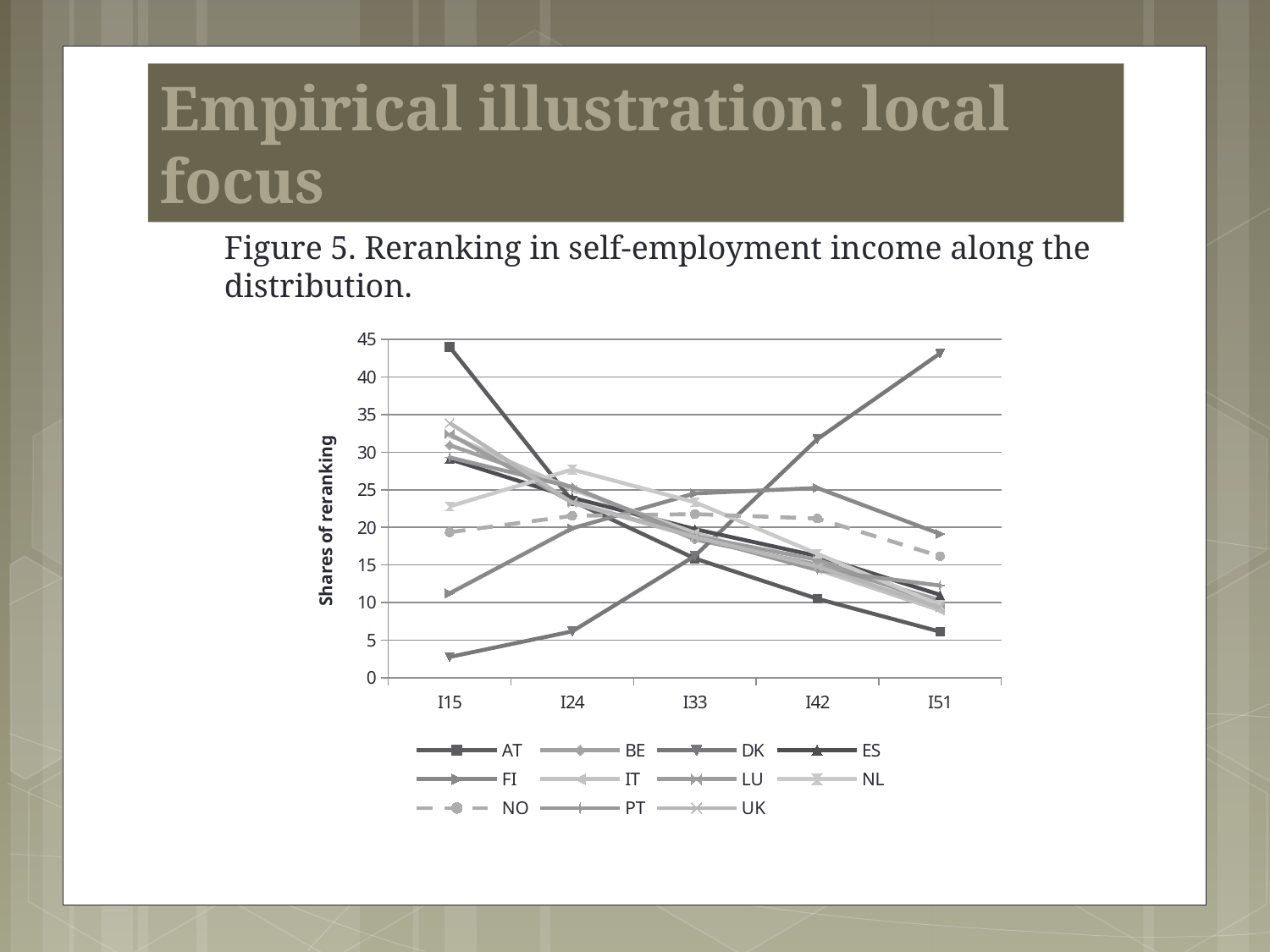
Does the FI series rise or fall from I15 to I51? rise Is the value for FI at I15 greater or less than 5? greater Which series has the highest value at I15? AT Is the value for AT at I15 greater or less than 40? greater How many categories are shown on the x axis? 5 Does the AT series rise or fall from I15 to I51? fall Which series has the highest value at I51? DK Is the value for AT at I51 greater or less than 10? less Which series has the lowest value at I15? DK How many series does the legend list? 11 What kind of chart is shown on the slide? line chart What is the title of the vertical axis? Shares of reranking